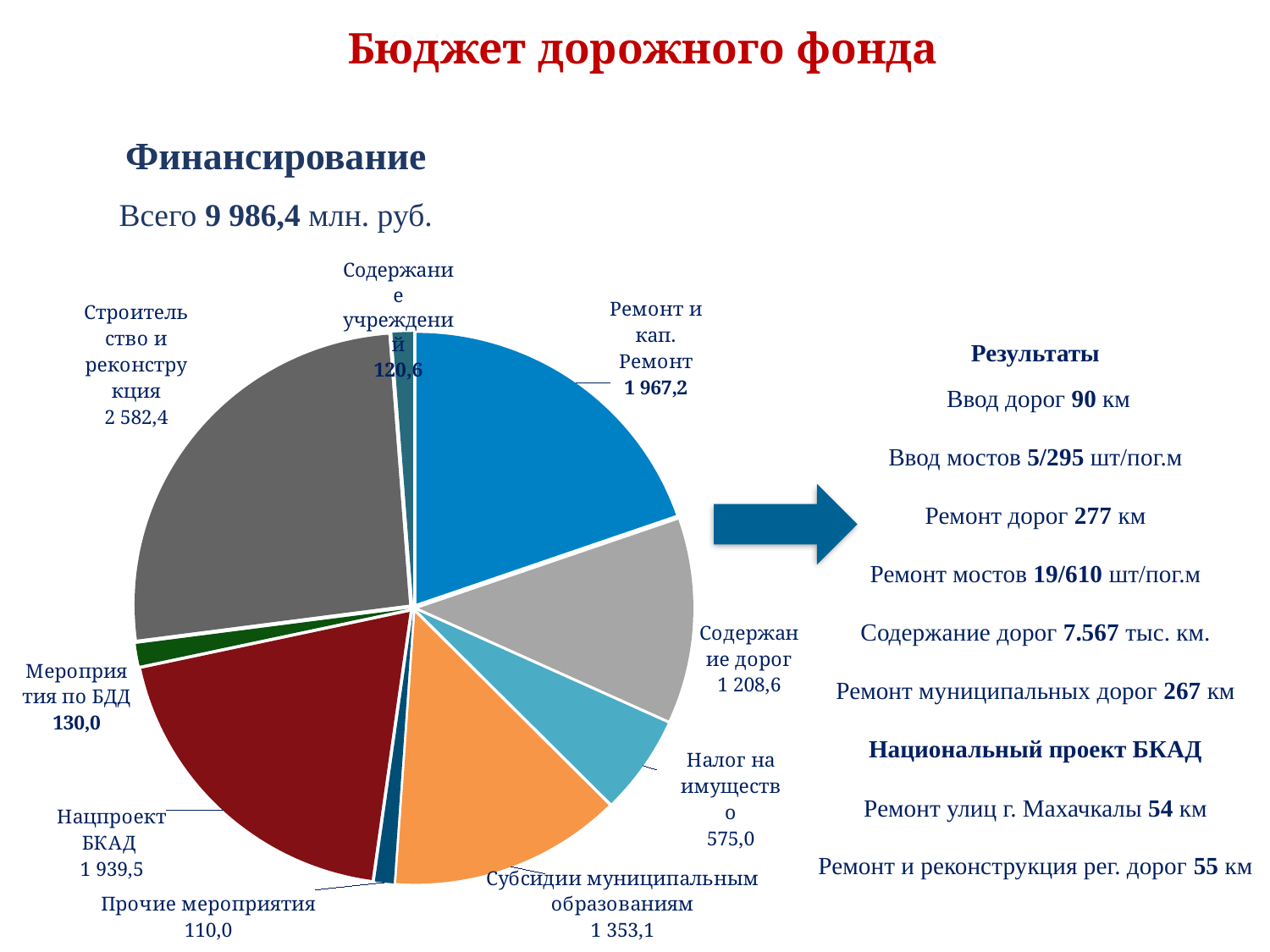
Which is larger: «Субсидии муниципальным образованиям» or «Содержание дорог»? Субсидии муниципальным образованиям What kind of chart is shown on the slide? Pie chart What is the value for «Ремонт и кап. Ремонт» in the pie chart? 1 967,2 What is the value for «Налог на имущество» in the pie chart? 575,0 Which category has the largest slice in the pie chart? Строительство и реконструкция Which category has the smallest slice in the pie chart? Прочие мероприятия What is the value for «Строительство и реконструкция» in the pie chart? 2 582,4 What total amount of financing is stated above the pie chart? 9 986,4 млн. руб. What is the value for «Субсидии муниципальным образованиям» in the pie chart? 1 353,1 What is the difference between «Строительство и реконструкция» and «Ремонт и кап. Ремонт»? 615,2 What is the title of the slide containing the pie chart? Бюджет дорожного фонда How many slices does the pie chart have? 9